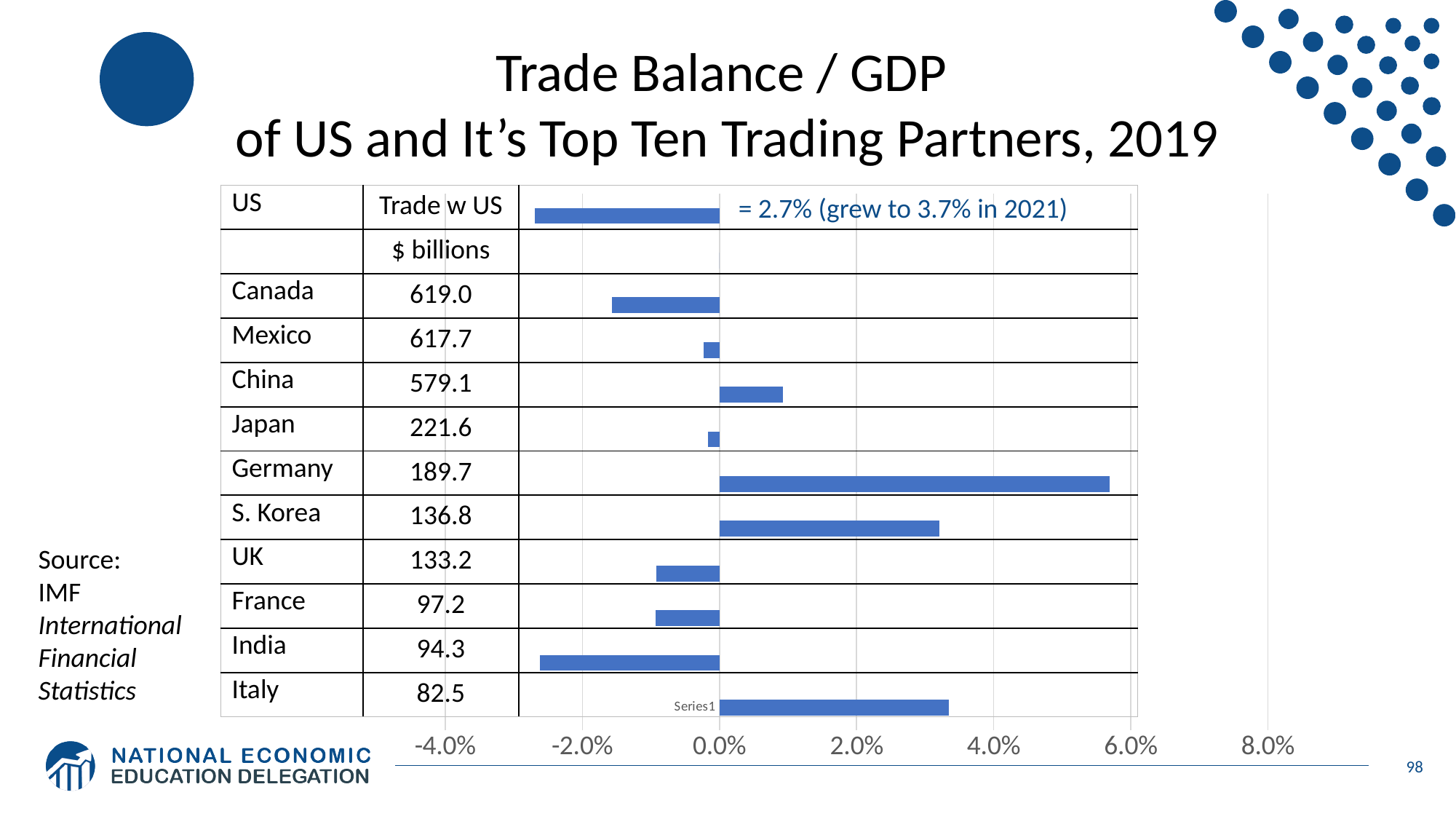
What is the title of the slide's chart? Trade Balance / GDP of US and It's Top Ten Trading Partners, 2019 Is the trade balance / GDP value for Germany greater or less than 4.0%? greater Is the trade balance / GDP value for India greater or less than -2.0%? less How many countries (bars) are plotted in the chart, including the US? 11 Which has the larger trade balance / GDP value, Germany or S. Korea? Germany Is the trade balance / GDP value for S. Korea greater or less than 2.0%? greater Which country has the highest trade balance / GDP value in the chart? Germany What kind of chart is shown on the slide? bar chart Which has the larger trade balance / GDP value, Canada or India? Canada According to the table next to the chart, what is Canada's trade with the US in $ billions? 619.0